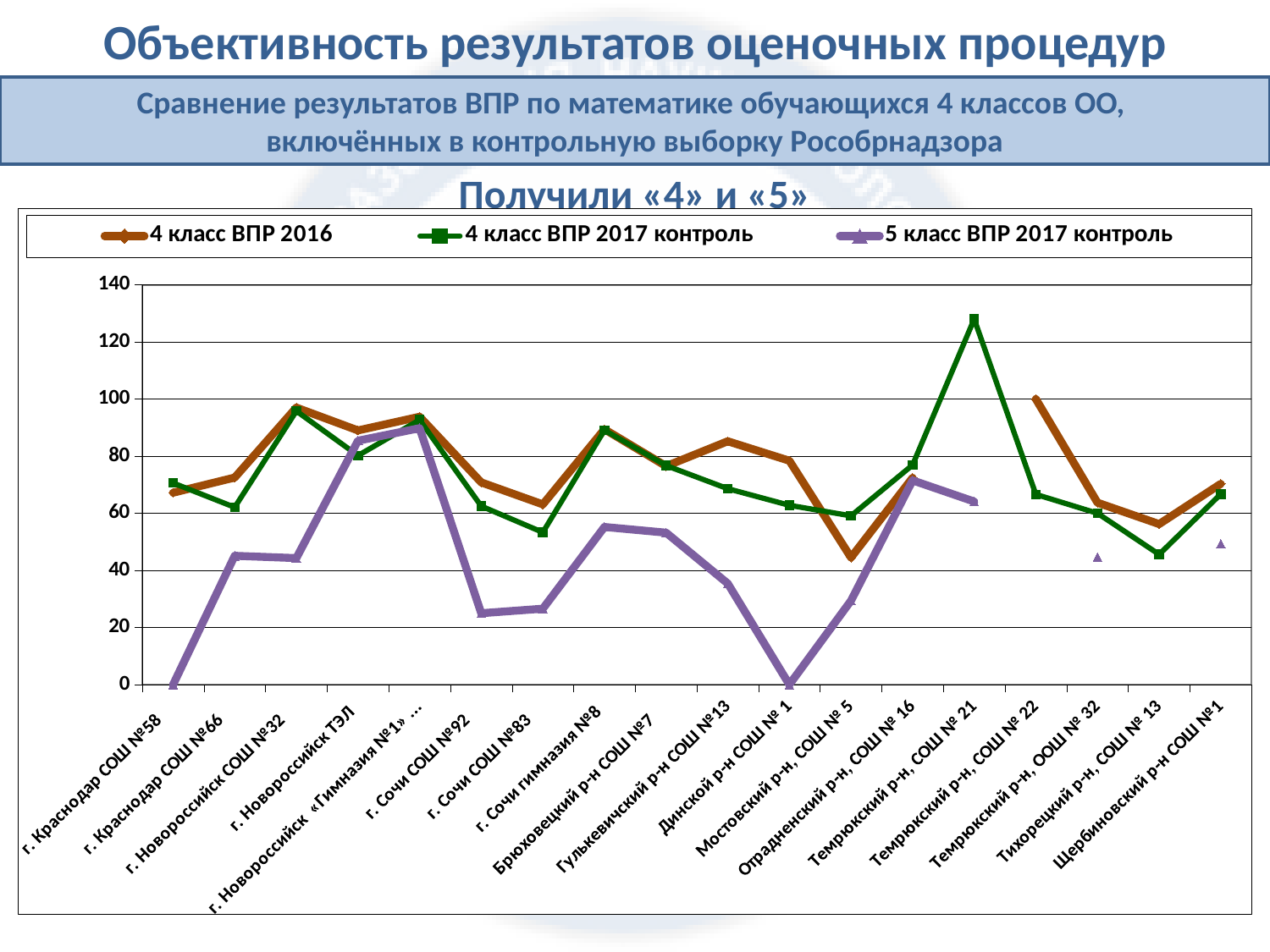
How many series does the legend list? 3 For the series «4 класс ВПР 2016», which school has the lowest value? Мостовский р-н, СОШ № 5 What is the title of the chart? Получили «4» и «5» How many schools (categories) are plotted along the x axis? 18 What kind of chart is shown on the slide? line chart Is the value of «4 класс ВПР 2016» for Мостовский р-н, СОШ № 5 greater or less than 60? less At г. Сочи СОШ №92, which series has the larger value: «4 класс ВПР 2016» or «5 класс ВПР 2017 контроль»? 4 класс ВПР 2016 For the series «4 класс ВПР 2017 контроль», which school has the highest value? Темрюкский р-н, СОШ № 21 For the series «4 класс ВПР 2017 контроль», which school has the lowest value? Тихорецкий р-н, СОШ № 13 Is the value of «5 класс ВПР 2017 контроль» for Динской р-н СОШ № 1 greater or less than 20? less Is the value of «4 класс ВПР 2017 контроль» for Темрюкский р-н, СОШ № 21 greater or less than 120? greater